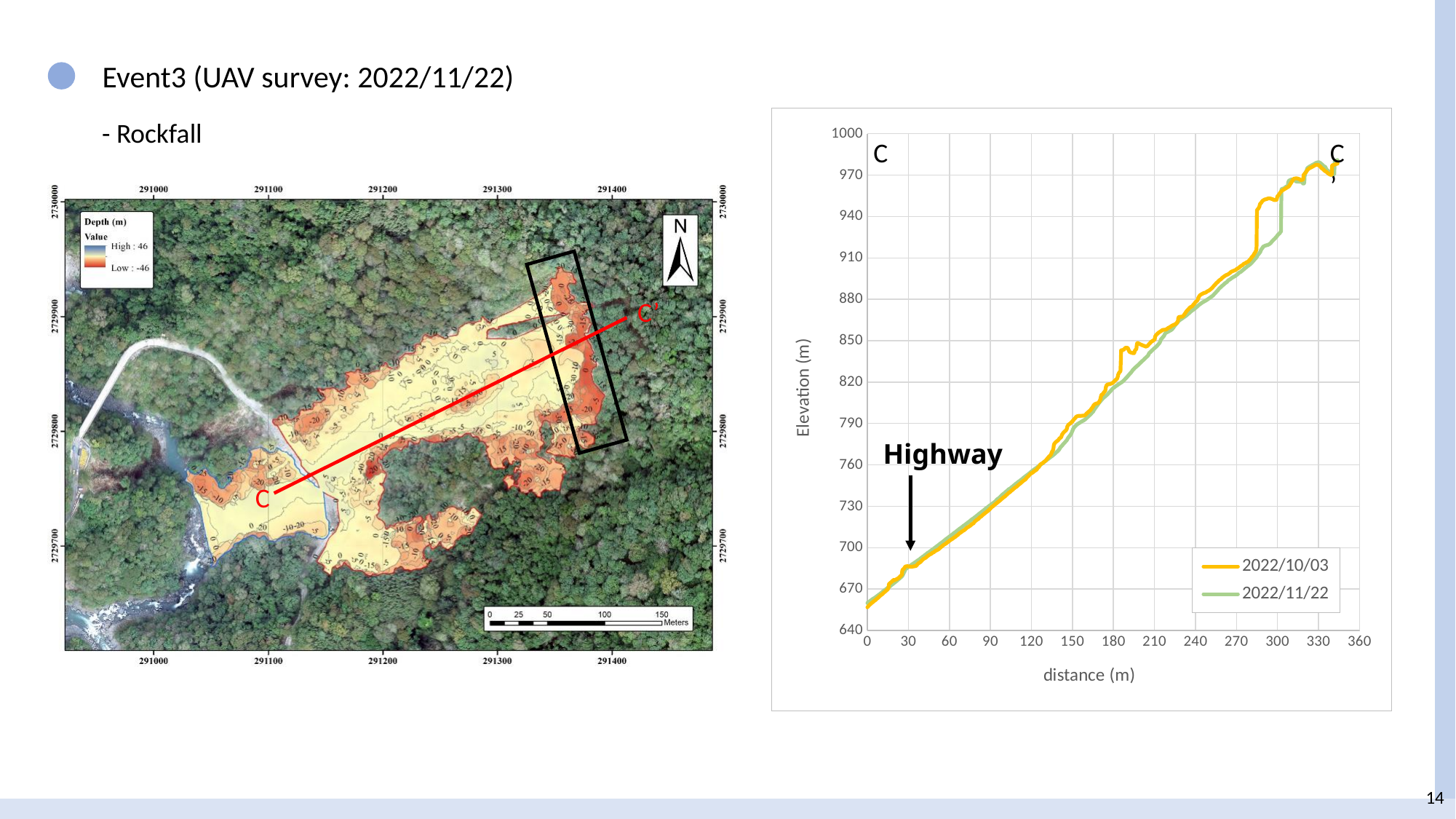
In the elevation chart, is the elevation at distance 120 m greater or less than 760? less In the elevation chart, is the elevation at distance 180 m greater or less than 790? greater How many series does the legend of the elevation chart list? 2 Do the elevation values rise or fall as distance increases along the x axis of the elevation chart? rise What are the two series named in the legend of the elevation chart? 2022/10/03 and 2022/11/22 What is the label of the vertical axis of the elevation chart? Elevation (m) What is the largest distance value shown on the x axis of the elevation chart? 360 What kind of chart is shown on the right side of the slide? line chart In the elevation chart, is the elevation at distance 0 m greater or less than 670? less In the elevation chart, at a distance of about 290 m, which series shows the higher elevation, 2022/10/03 or 2022/11/22? 2022/10/03